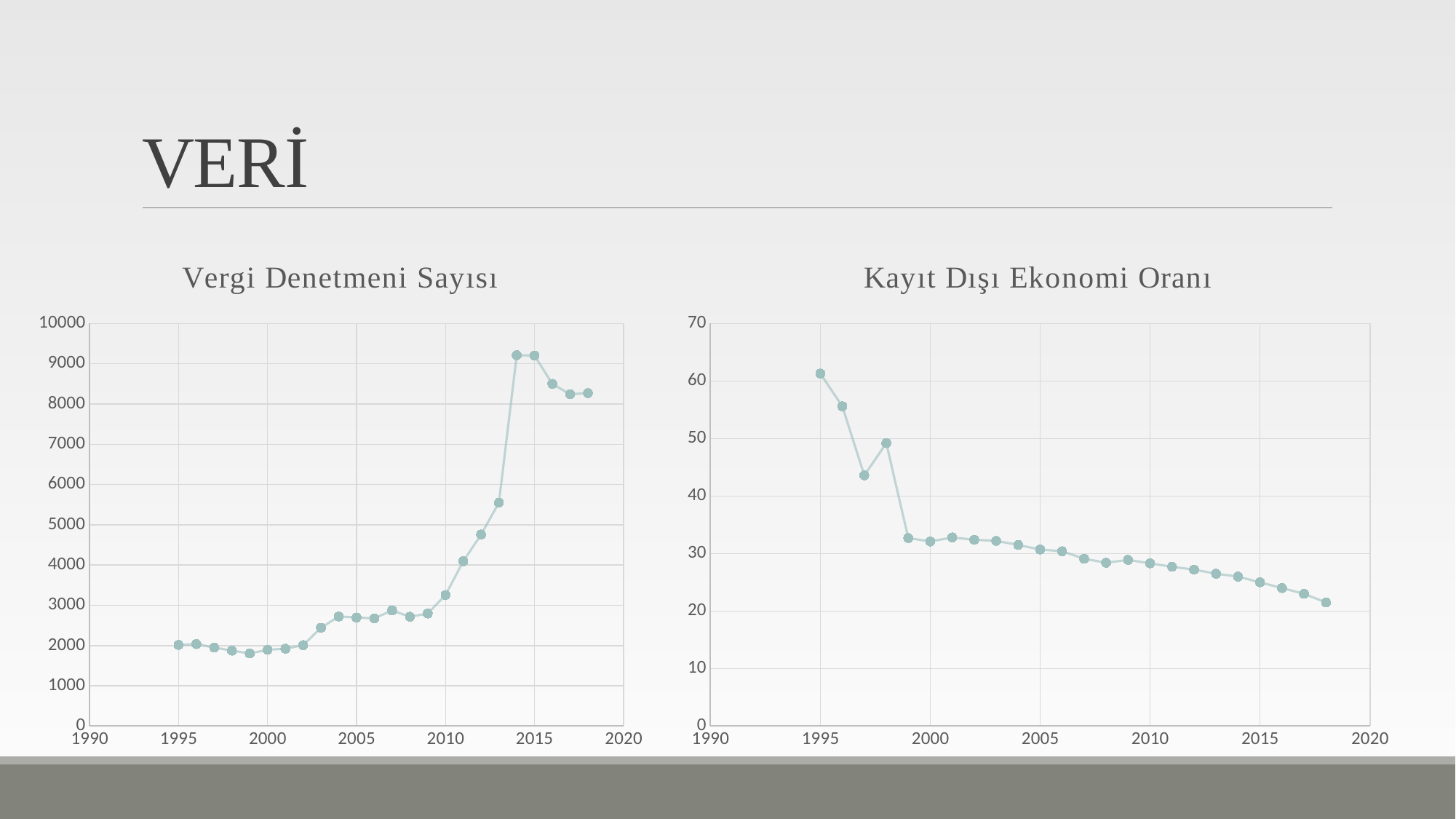
In the "Kayıt Dışı Ekonomi Oranı" chart, is the value for 2018 greater or less than 30? less In the "Vergi Denetmeni Sayısı" chart, which year has the larger value, 2010 or 2014? 2014 What is the title of the chart on the right? Kayıt Dışı Ekonomi Oranı In the "Kayıt Dışı Ekonomi Oranı" chart, which year has the lowest value? 2018 In the "Kayıt Dışı Ekonomi Oranı" chart, which year has the highest value? 1995 In the "Vergi Denetmeni Sayısı" chart, is the value for 2013 greater or less than 5000? greater In the "Vergi Denetmeni Sayısı" chart, do the values overall rise or fall from 1995 to 2018? rise In the "Vergi Denetmeni Sayısı" chart, is the value for 2003 greater or less than 3000? less In the "Kayıt Dışı Ekonomi Oranı" chart, which year has the larger value, 1996 or 1997? 1996 What kind of chart is the "Vergi Denetmeni Sayısı" chart on the left? line chart In the "Kayıt Dışı Ekonomi Oranı" chart, do the values overall rise or fall from 1995 to 2018? fall